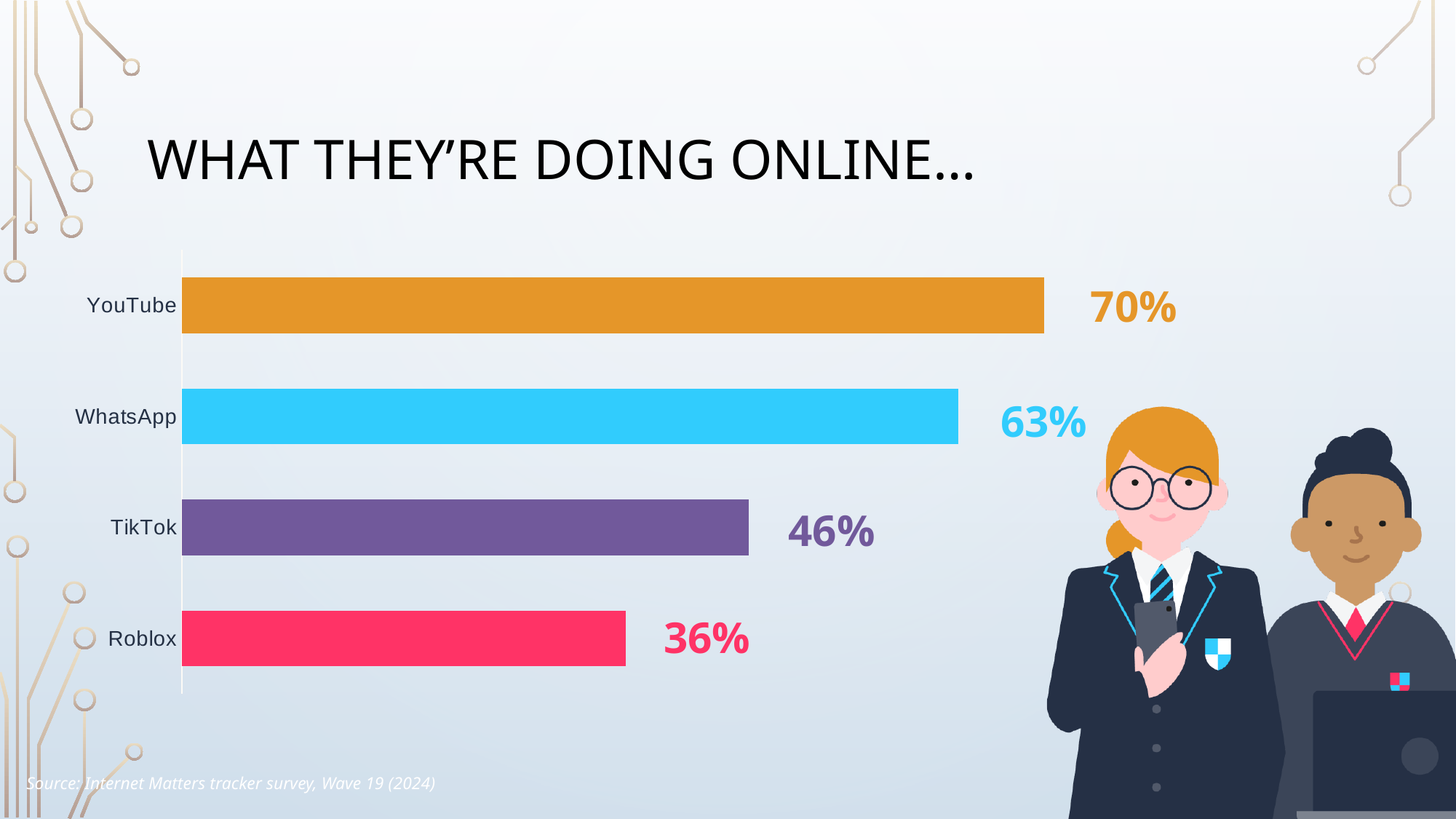
Which has a larger value, WhatsApp or TikTok? WhatsApp What is the difference between the values for TikTok and Roblox? 10% How many categories are shown in the chart? 4 What is the difference between the values for YouTube and WhatsApp? 7% What is the title of the slide containing the chart? WHAT THEY'RE DOING ONLINE... Which category has the highest value? YouTube What kind of chart is shown on the slide? Bar chart Which category has the lowest value? Roblox What is the value for TikTok? 46% What is the value for YouTube? 70% What is the value for Roblox? 36% What is the value for WhatsApp? 63%